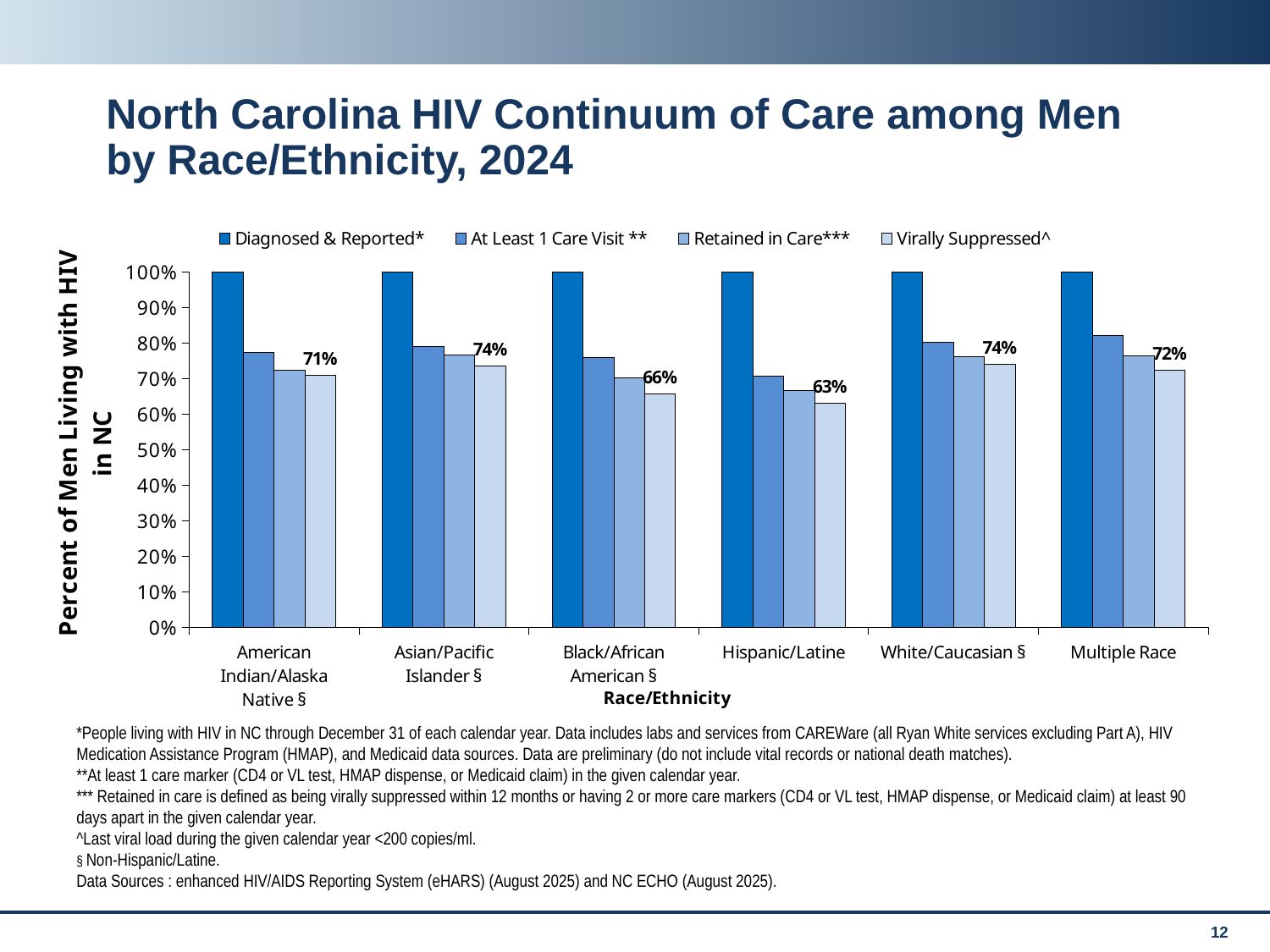
What is the Virally Suppressed^ value for Multiple Race men? 72% Which race/ethnicity has the lowest Virally Suppressed^ value? Hispanic/Latine What is the Virally Suppressed^ value for Hispanic/Latine men? 63% What is the difference between the Virally Suppressed^ values for White/Caucasian and Hispanic/Latine men? 11 percentage points Is the Retained in Care*** value for Hispanic/Latine men greater or less than 70%? less How many race/ethnicity categories are shown on the x axis? 6 How many series does the legend list? 4 Which is larger, the Virally Suppressed^ value for Multiple Race or for American Indian/Alaska Native? Multiple Race What type of chart is shown on the slide? Bar chart What is the Diagnosed & Reported* value for White/Caucasian men? 100% What is the title of the y axis? Percent of Men Living with HIV in NC What is the Virally Suppressed^ value for Black/African American men? 66%